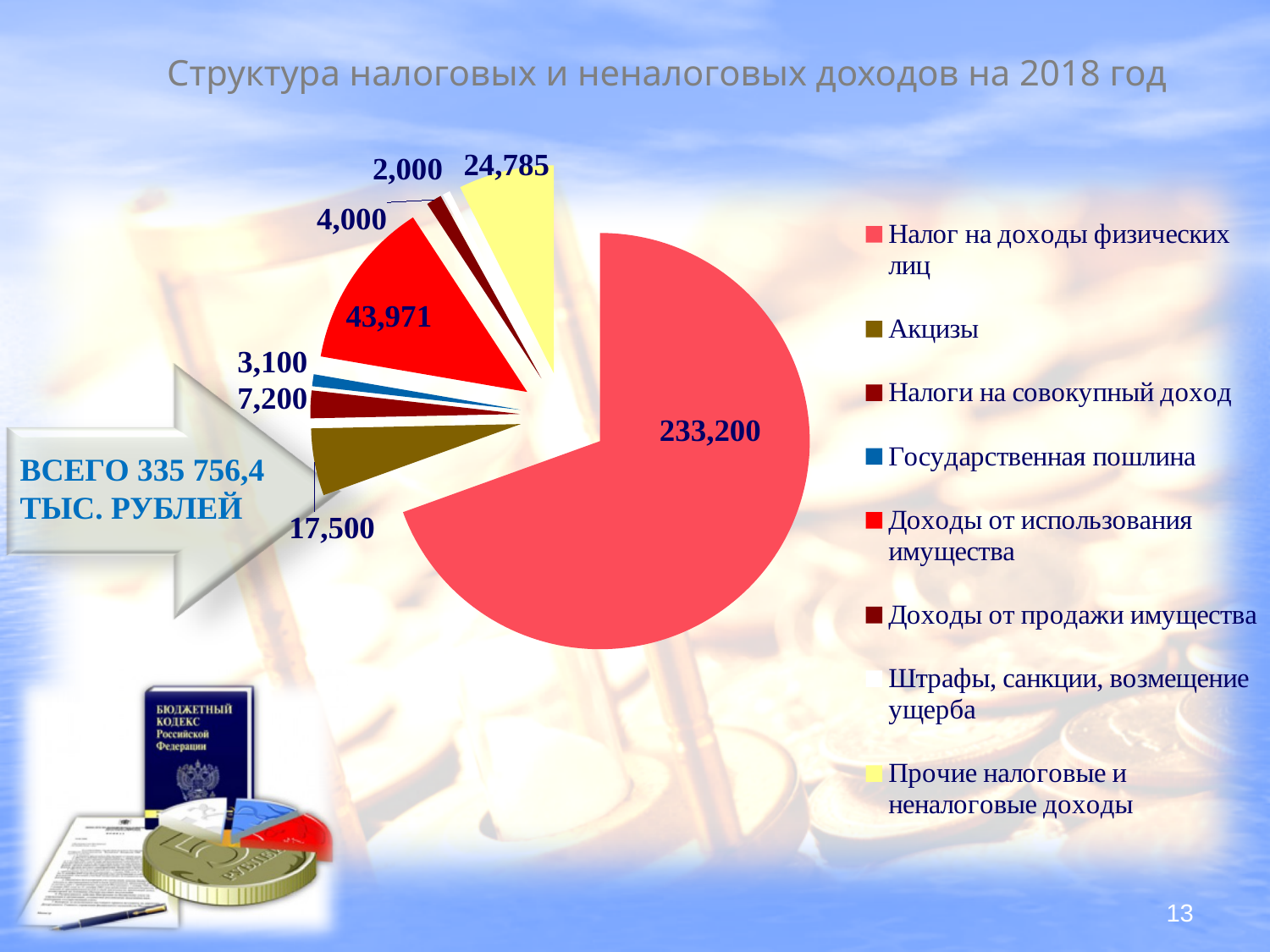
Which category has the largest slice of the pie? Налог на доходы физических лиц What is the value for Налог на доходы физических лиц? 233,200 What is the value for Акцизы? 17,500 What is the value for Доходы от использования имущества? 43,971 What is the value for Государственная пошлина? 3,100 What is the difference between the values for Доходы от использования имущества and Прочие налоговые и неналоговые доходы? 19,186 How many categories does the legend list? 8 What is the value for Прочие налоговые и неналоговые доходы? 24,785 What is the title of the chart? Структура налоговых и неналоговых доходов на 2018 год Which is larger: the value for Акцизы or the value for Налоги на совокупный доход? Акцизы What kind of chart is shown on the slide? Pie chart Which category has the smallest slice of the pie? Штрафы, санкции, возмещение ущерба